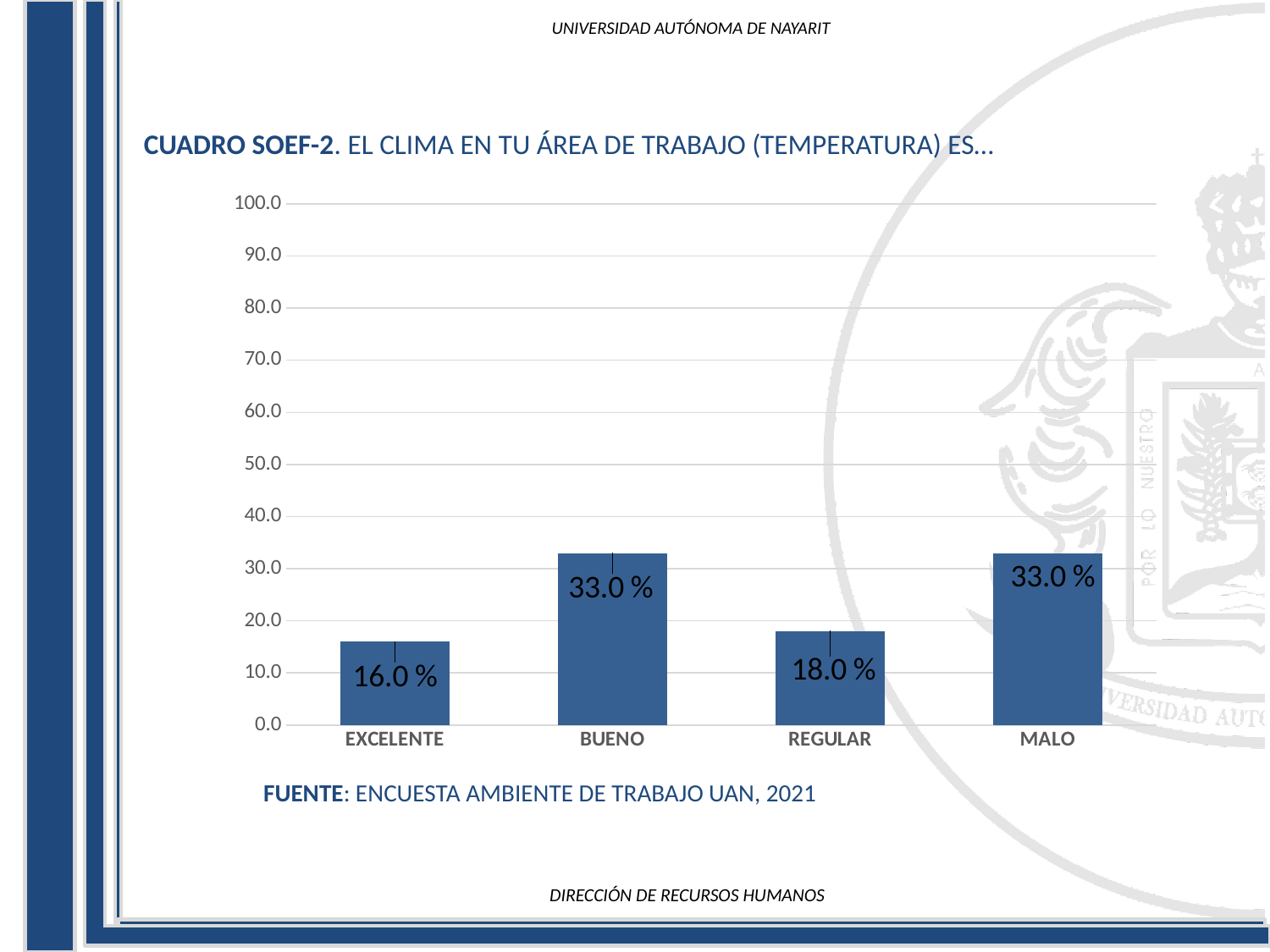
Which is larger, the value for REGULAR or the value for MALO? MALO Which category has the lowest value? EXCELENTE What is the source cited below the chart? ENCUESTA AMBIENTE DE TRABAJO UAN, 2021 What is the value for MALO? 33.0 % What is the difference between the values for BUENO and EXCELENTE? 17.0 % What is the value for EXCELENTE? 16.0 % What kind of chart is shown on the slide? bar chart Is the value for BUENO greater or less than 30.0? greater What is the value for REGULAR? 18.0 % What is the value for BUENO? 33.0 % How many categories are shown on the x axis? 4 What is the difference between the values for REGULAR and EXCELENTE? 2.0 %